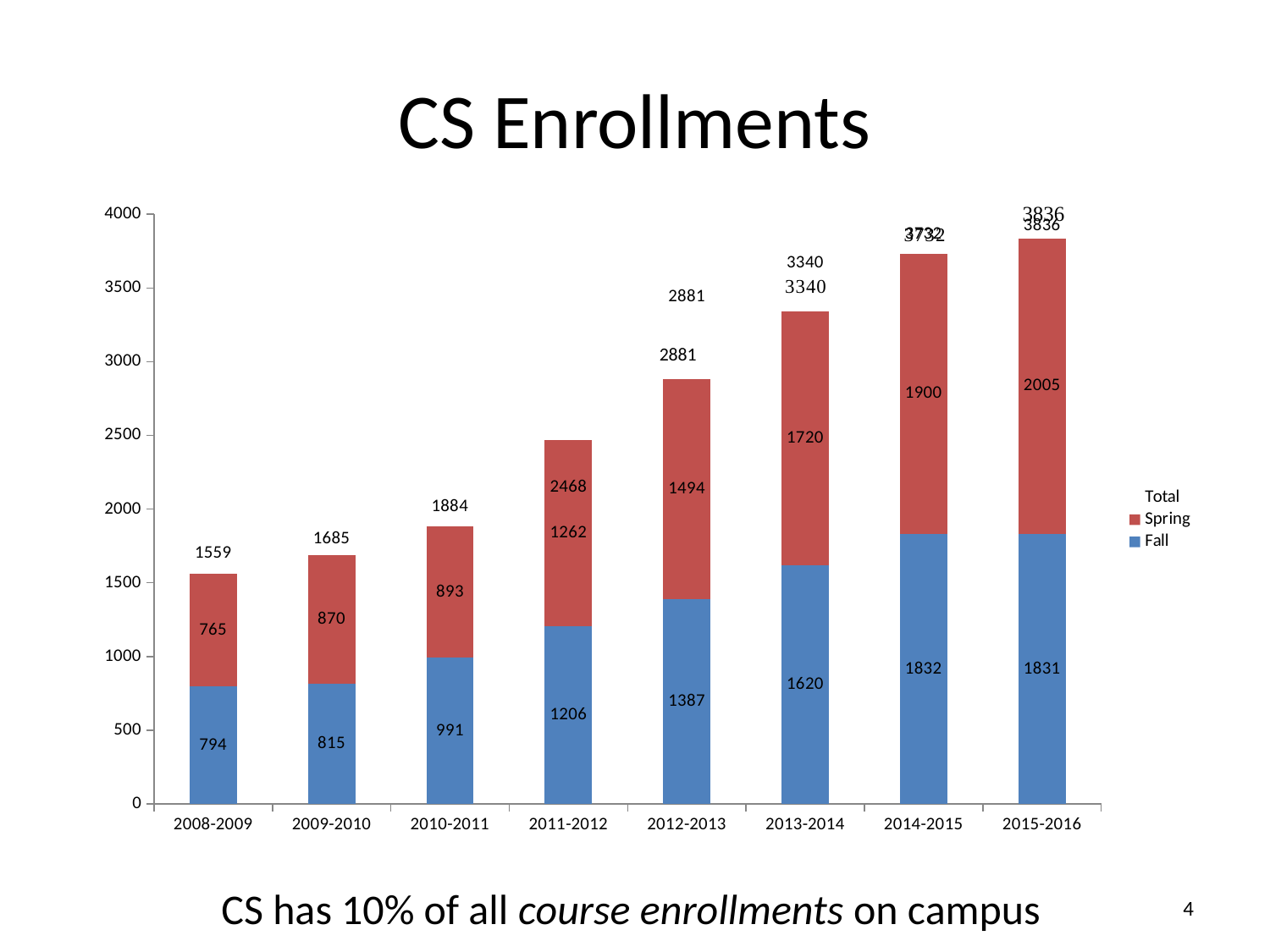
How much higher is the Spring enrollment in 2015-2016 than in 2014-2015? 105 Do the total enrollments rise or fall from 2008-2009 to 2015-2016? Rise How many entries does the legend list? 3 In 2008-2009, which is larger, the Fall or the Spring enrollment? Fall Which academic year has the highest total enrollment? 2015-2016 Which academic year has the lowest Fall enrollment? 2008-2009 How many academic years are shown on the x axis? 8 What is the Fall enrollment for 2012-2013? 1387 Is the Fall enrollment for 2013-2014 greater or less than 1500? greater What is the total enrollment for 2013-2014? 3340 What is the Spring enrollment for 2015-2016? 2005 What kind of chart is shown on the slide? Stacked bar chart